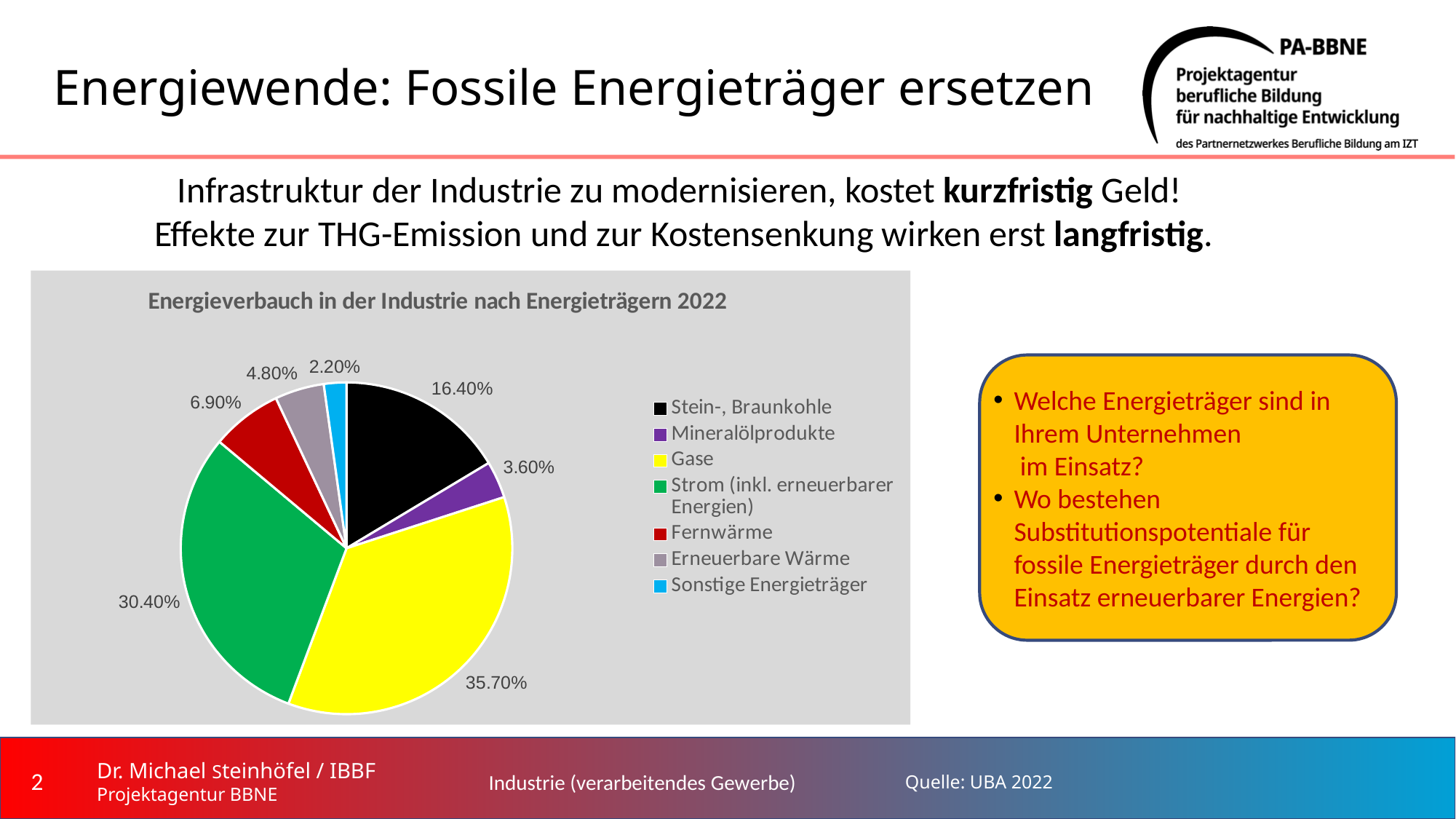
What is the value for Strom (inkl. erneuerbarer Energien)? 30.40% Which energy source has the smallest share of the pie? Sonstige Energieträger What kind of chart is shown on the slide? Pie chart What is the title of the chart? Energieverbauch in der Industrie nach Energieträgern 2022 What is the value for Fernwärme? 6.90% Which is larger, the share of Erneuerbare Wärme or the share of Mineralölprodukte? Erneuerbare Wärme Which energy source has the largest share of the pie? Gase What is the difference between the shares of Gase and Strom (inkl. erneuerbarer Energien)? 5.30% Which colour represents Fernwärme in the pie chart? Red What is the value for Stein-, Braunkohle? 16.40% How many slices does the pie chart have? 7 What share of the pie does Gase have? 35.70%